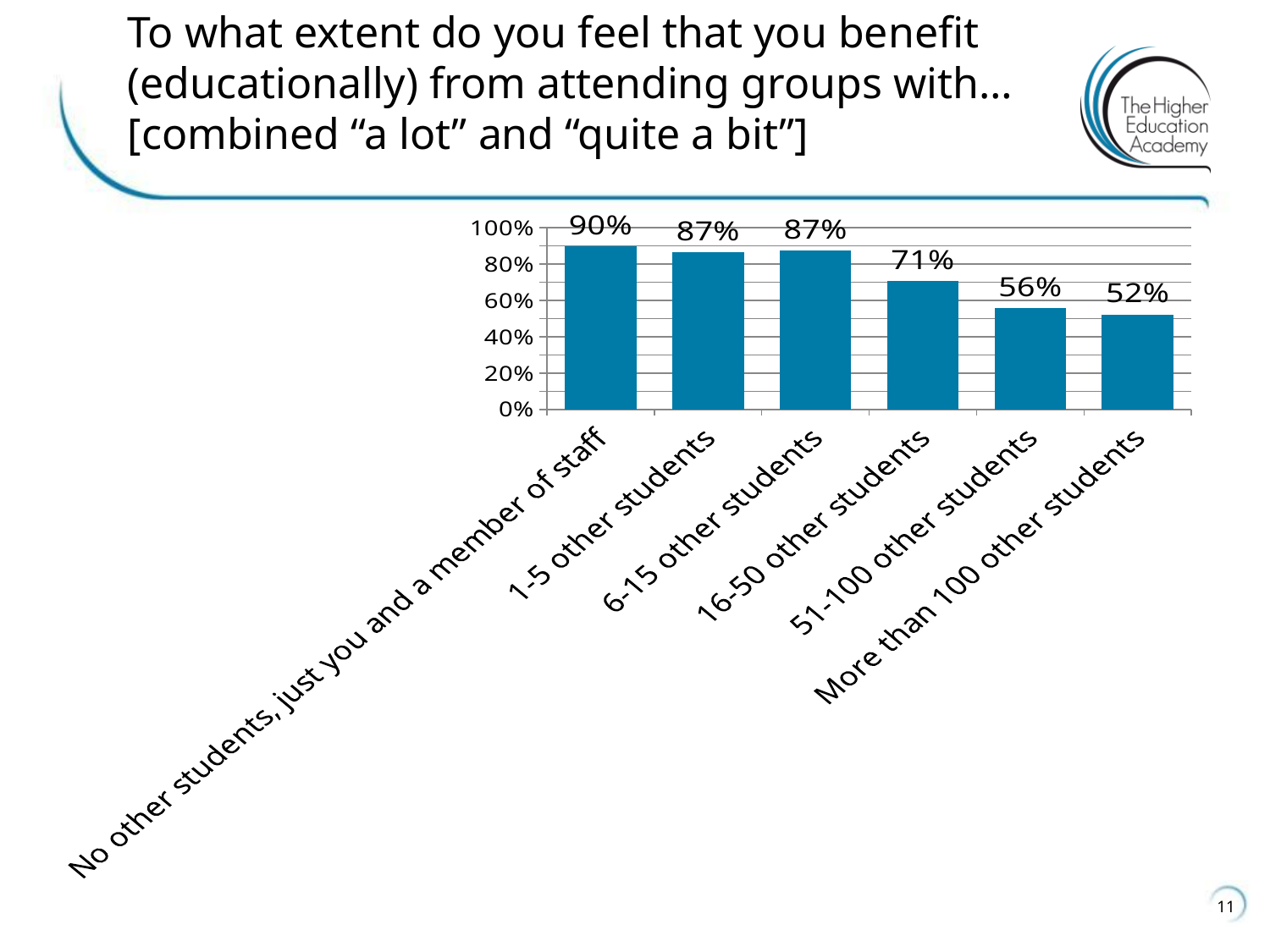
What kind of chart is shown on the slide? Bar chart Which category has the highest value? No other students, just you and a member of staff What is the value for "1-5 other students"? 87% What is the value for "16-50 other students"? 71% What is the difference between the values for "16-50 other students" and "More than 100 other students"? 19% Which category has the lowest value? More than 100 other students Which is larger, the value for "6-15 other students" or the value for "51-100 other students"? 6-15 other students What is the maximum value shown on the y axis? 100% Do the values generally rise or fall from left to right along the x axis? Fall What is the difference between the values for "No other students, just you and a member of staff" and "51-100 other students"? 34% What is the value for "More than 100 other students"? 52% How many categories are shown on the x axis? 6